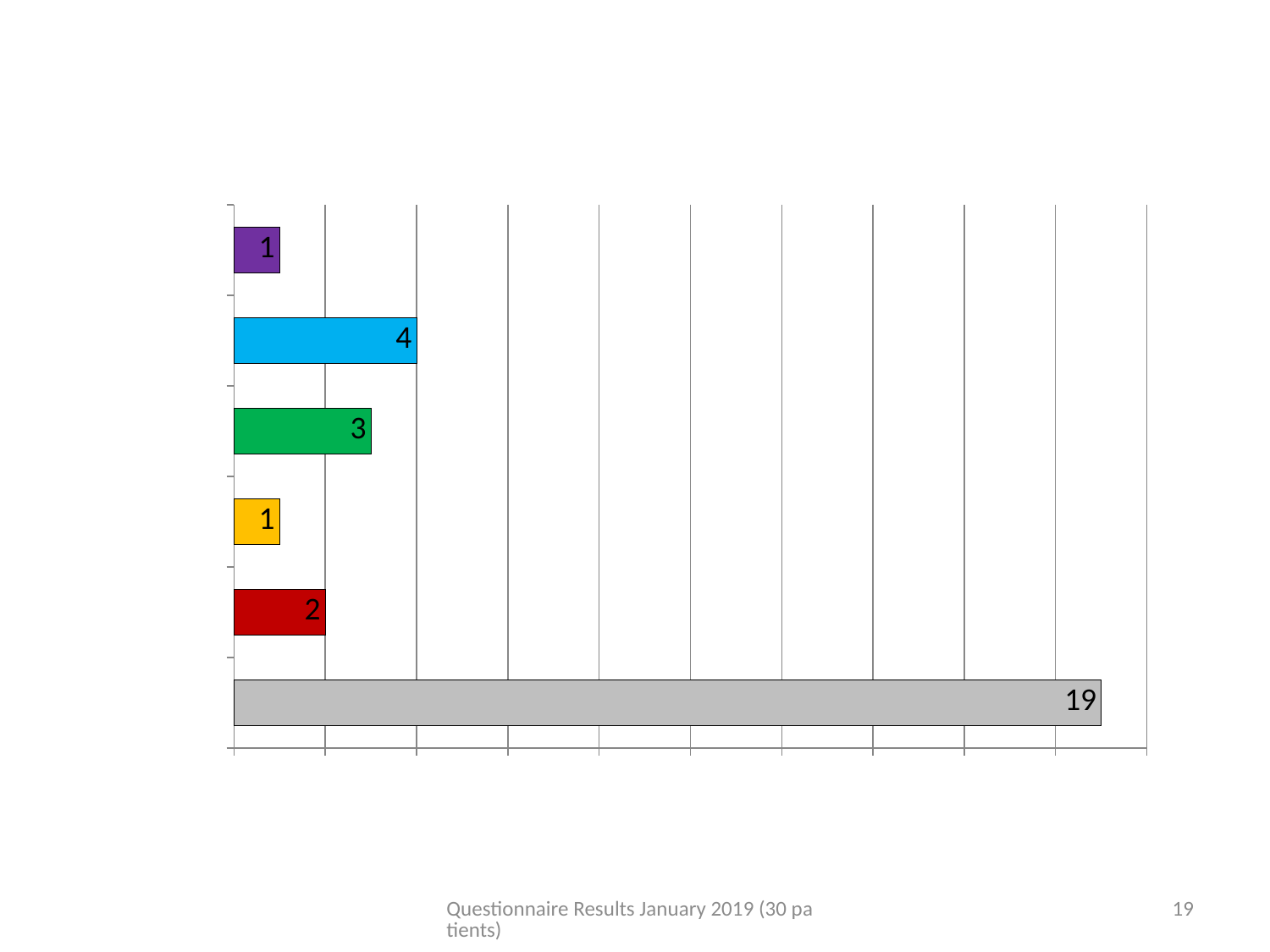
What is the value shown on the red bar? 2 What is the difference between the grey bar's value and the blue bar's value? 15 Which bar has the highest value? the grey bar (19) How many bars are plotted in the chart? 6 What is the difference between the blue bar's value and the green bar's value? 1 What is the value shown on the green bar? 3 Which is larger, the value of the green bar or the value of the red bar? the green bar What is the value shown on the grey bar at the bottom of the chart? 19 What is the value shown on the purple bar at the top of the chart? 1 What colour is the bar with the largest value? grey What is the value shown on the blue bar? 4 What type of chart is shown on the slide? bar chart